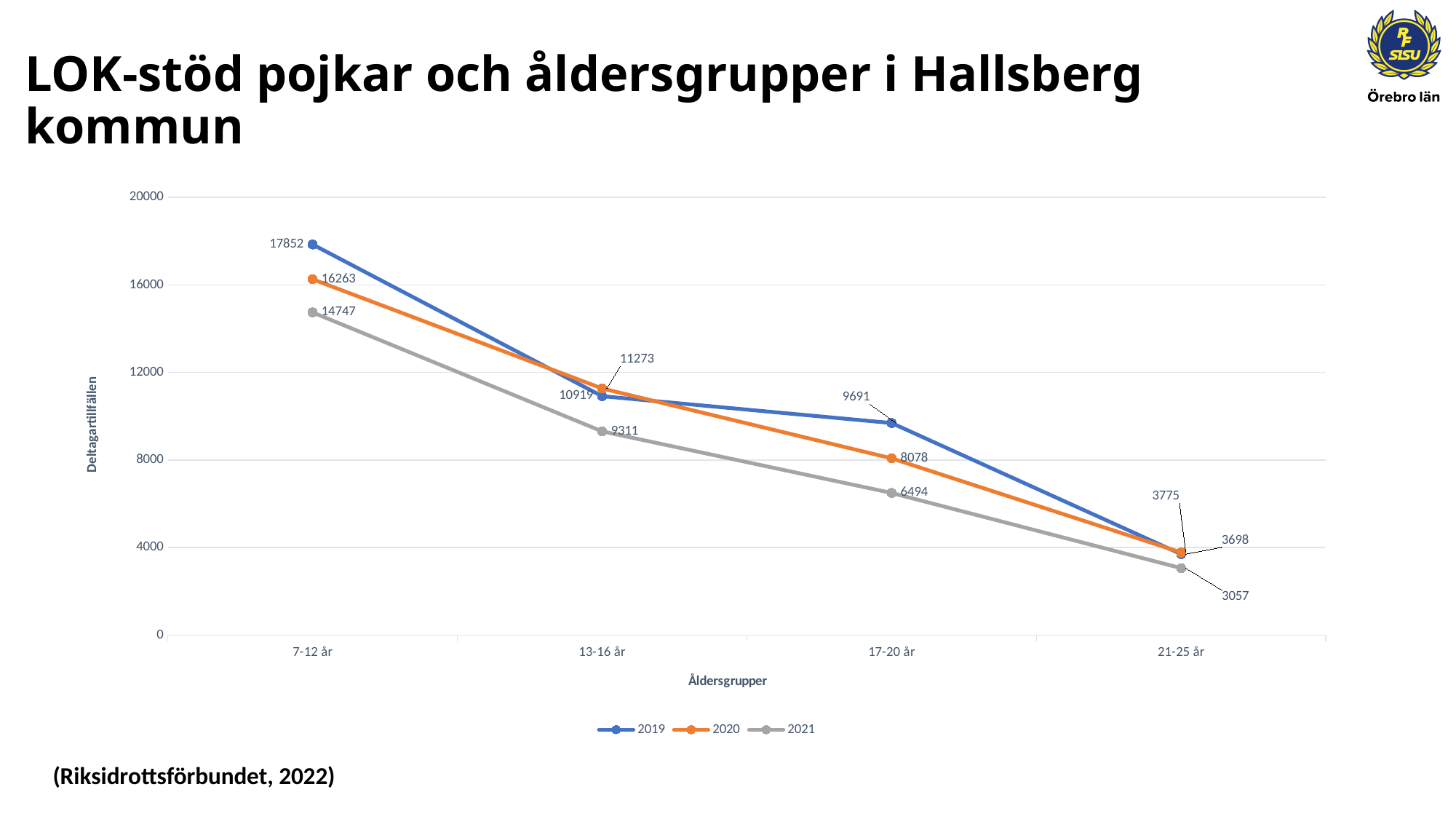
How many age groups are shown on the x axis? 4 What is the value for 2019 in the 7-12 år age group? 17852 Which age group has the lowest value for the 2021 series? 21-25 år What is the value for 2020 in the 13-16 år age group? 11273 Do the values for the 2019 series rise or fall from 7-12 år to 21-25 år? fall What is the value for 2021 in the 17-20 år age group? 6494 In the 13-16 år age group, which series has the larger value, 2019 or 2020? 2020 What type of chart is shown on the slide? line chart What is the label of the y axis? Deltagartillfällen Which age group has the highest value for the 2020 series? 7-12 år How many series does the legend list? 3 What is the difference between the 2019 and 2021 values in the 7-12 år age group? 3105